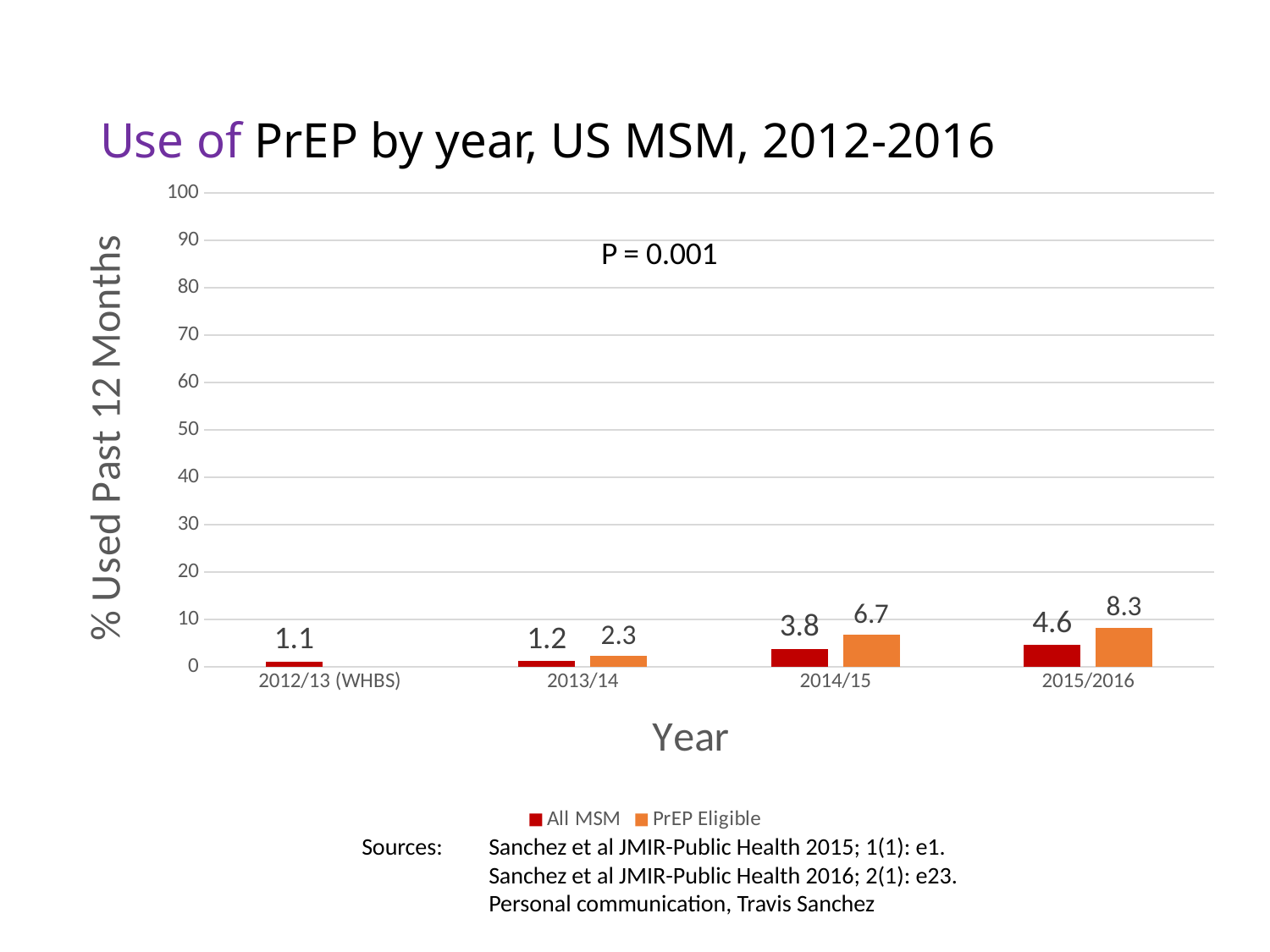
What is the value for All MSM in 2015/2016? 4.6 Do the All MSM values rise or fall from 2012/13 to 2015/2016? rise Is the value for PrEP Eligible in 2015/2016 greater or less than 10? less How many series does the legend list? 2 Which year has the highest value for PrEP Eligible? 2015/2016 What kind of chart is shown? bar chart What is the value for PrEP Eligible in 2014/15? 6.7 Which is larger in 2013/14, All MSM or PrEP Eligible? PrEP Eligible What is the value for All MSM in 2012/13 (WHBS)? 1.1 How many year categories are shown on the x axis? 4 What is the difference between PrEP Eligible and All MSM in 2015/2016? 3.7 Which year has the lowest value for All MSM? 2012/13 (WHBS)